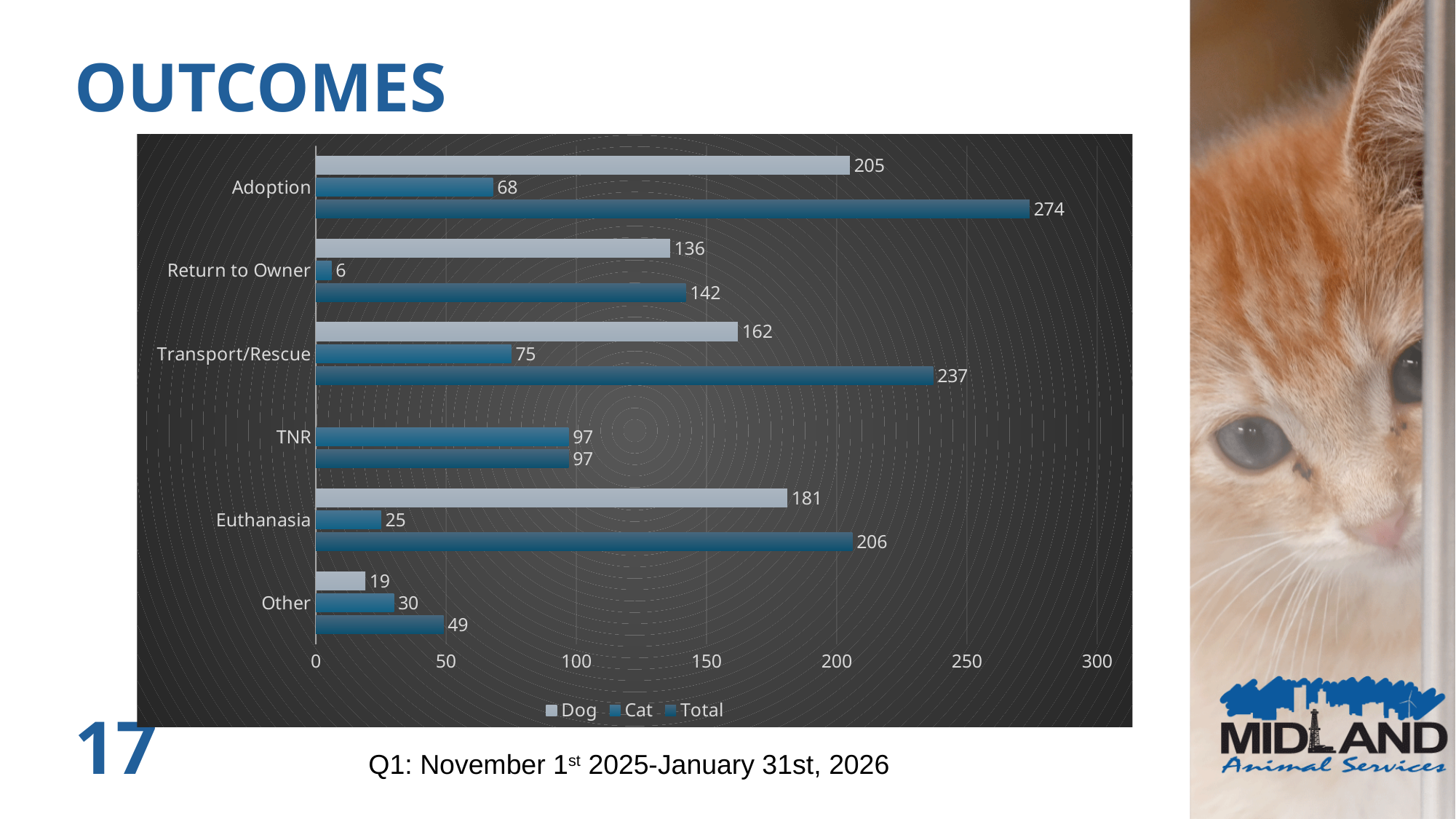
What kind of chart is shown on the slide? Bar chart Which is larger, the Cat value for Transport/Rescue or the Cat value for Adoption? Transport/Rescue Which category has the lowest Total value? Other How many categories are shown on the y axis? 6 What is the Cat value for Euthanasia? 25 How many series does the legend list? 3 Which category has the highest Total value? Adoption What is the difference between the Dog and Cat values for Adoption? 137 What is the Dog value for Adoption? 205 What are the series names listed in the legend? Dog, Cat, Total What is the Cat value for Return to Owner? 6 What is the Total value for Transport/Rescue? 237